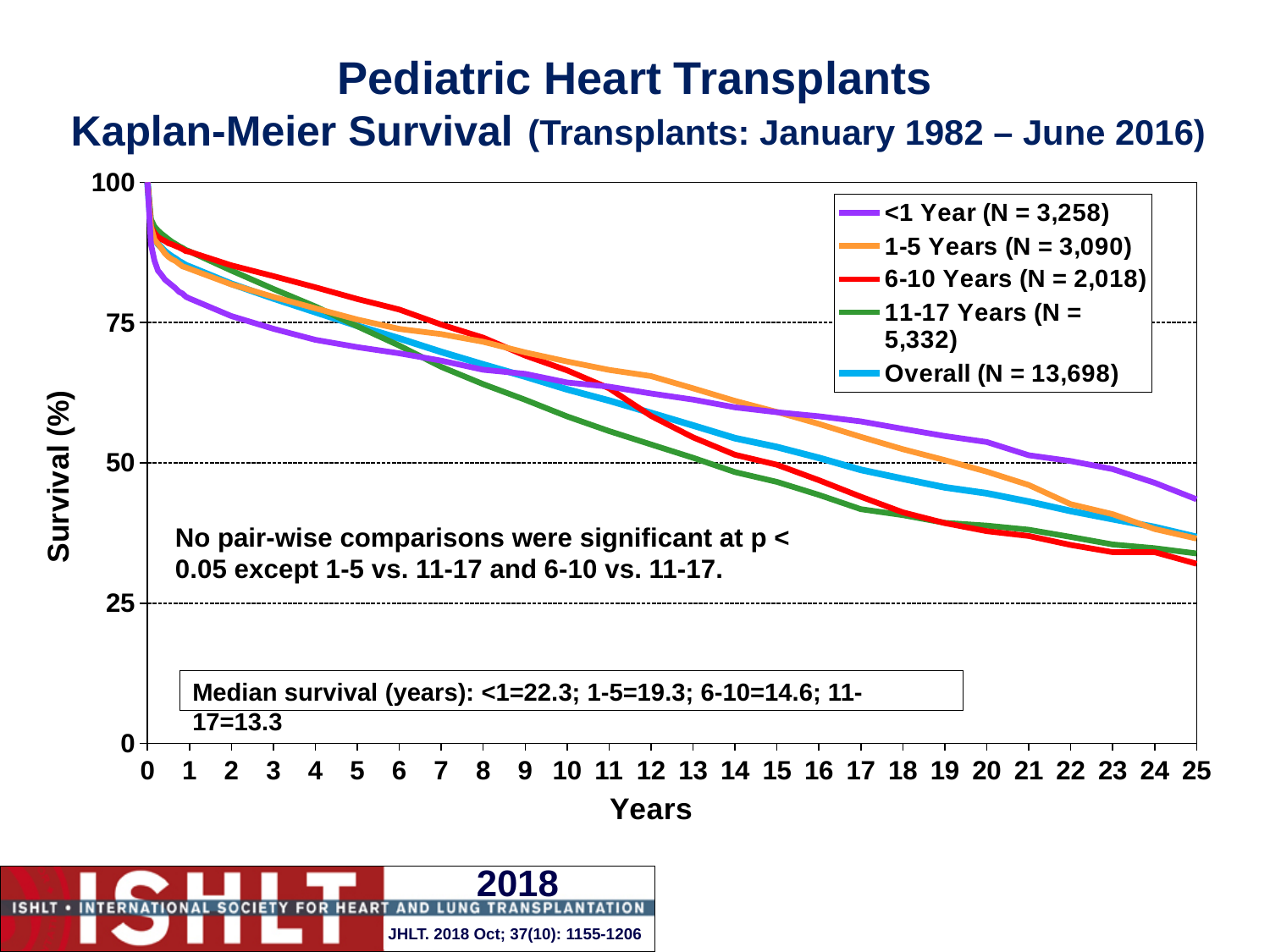
How many series does the legend list? 5 At 25 years, which group has higher survival, <1 Year or 6-10 Years? <1 Year What is the median survival in years for the <1 Year group? 22.3 What is the N for the Overall series in the legend? 13,698 Which age group has the highest median survival? <1 Year What is the difference in median survival (years) between the <1 Year group and the 11-17 Years group? 9.0 What is the label of the x axis? Years At 25 years, is the survival for the 6-10 Years group greater or less than 50? less Which age group has the lowest median survival? 11-17 Years Do the survival curves rise or fall as years increase? fall What kind of chart is shown on the slide? line chart What is the median survival in years for the 6-10 Years group? 14.6